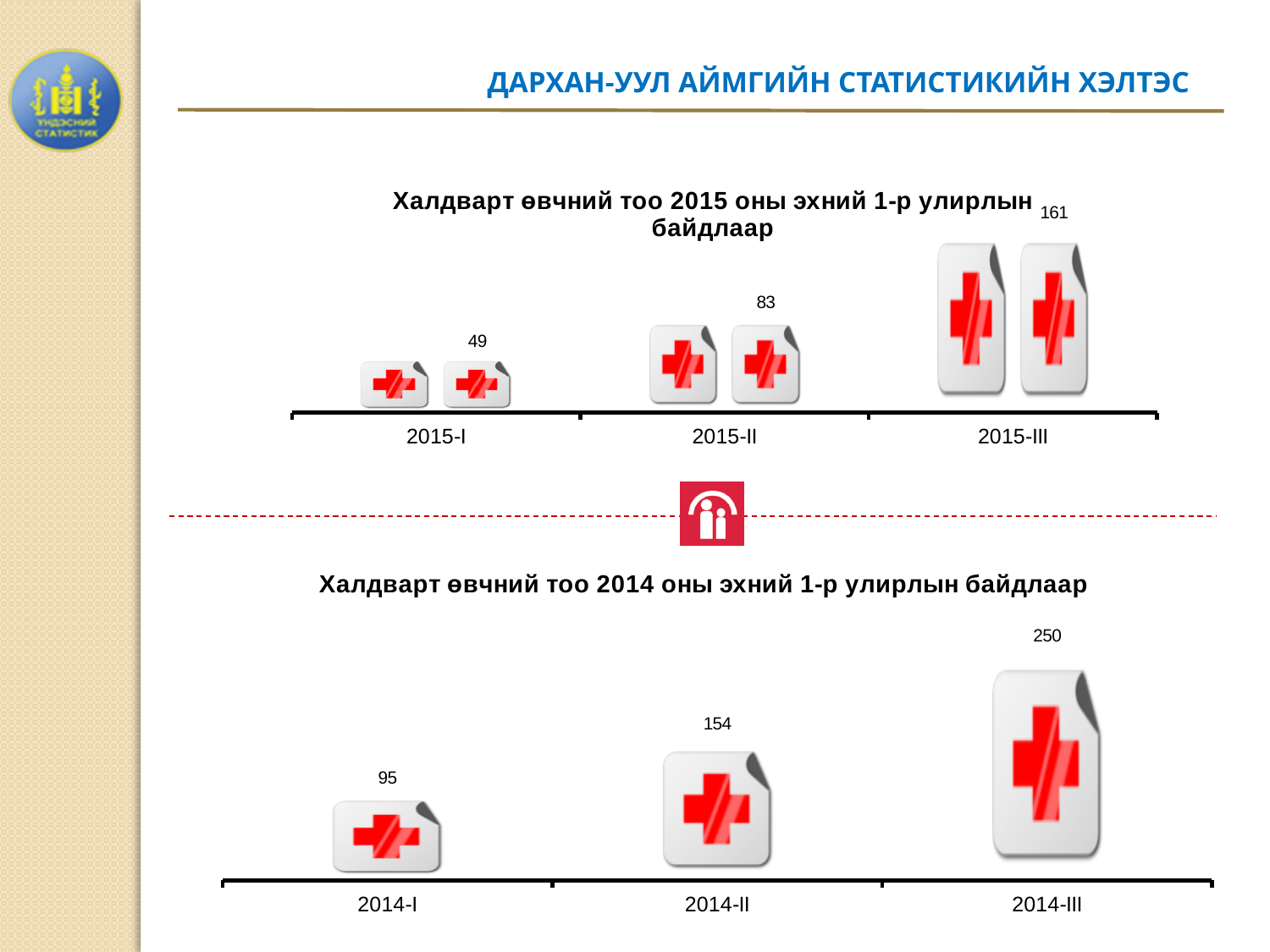
In the bottom chart (2014), which category has the lowest value? 2014-I In the top chart (2015), what is the value for 2015-III? 161 What is the title of the bottom chart? Халдварт өвчний тоо 2014 оны эхний 1-р улирлын байдлаар In the bottom chart (2014), what is the value for 2014-I? 95 In the bottom chart (2014), which is larger, the value for 2014-II or 2014-III? 2014-III In the bottom chart (2014), what is the value for 2014-III? 250 How many categories are shown in the top chart (2015)? 3 Do the values in the bottom chart (2014) rise or fall from 2014-I to 2014-III? rise In the top chart (2015), what is the value for 2015-II? 83 In the bottom chart (2014), what is the difference between the values for 2014-II and 2014-I? 59 In the top chart (2015), which category has the highest value? 2015-III In the top chart (2015), what is the difference between the values for 2015-III and 2015-I? 112